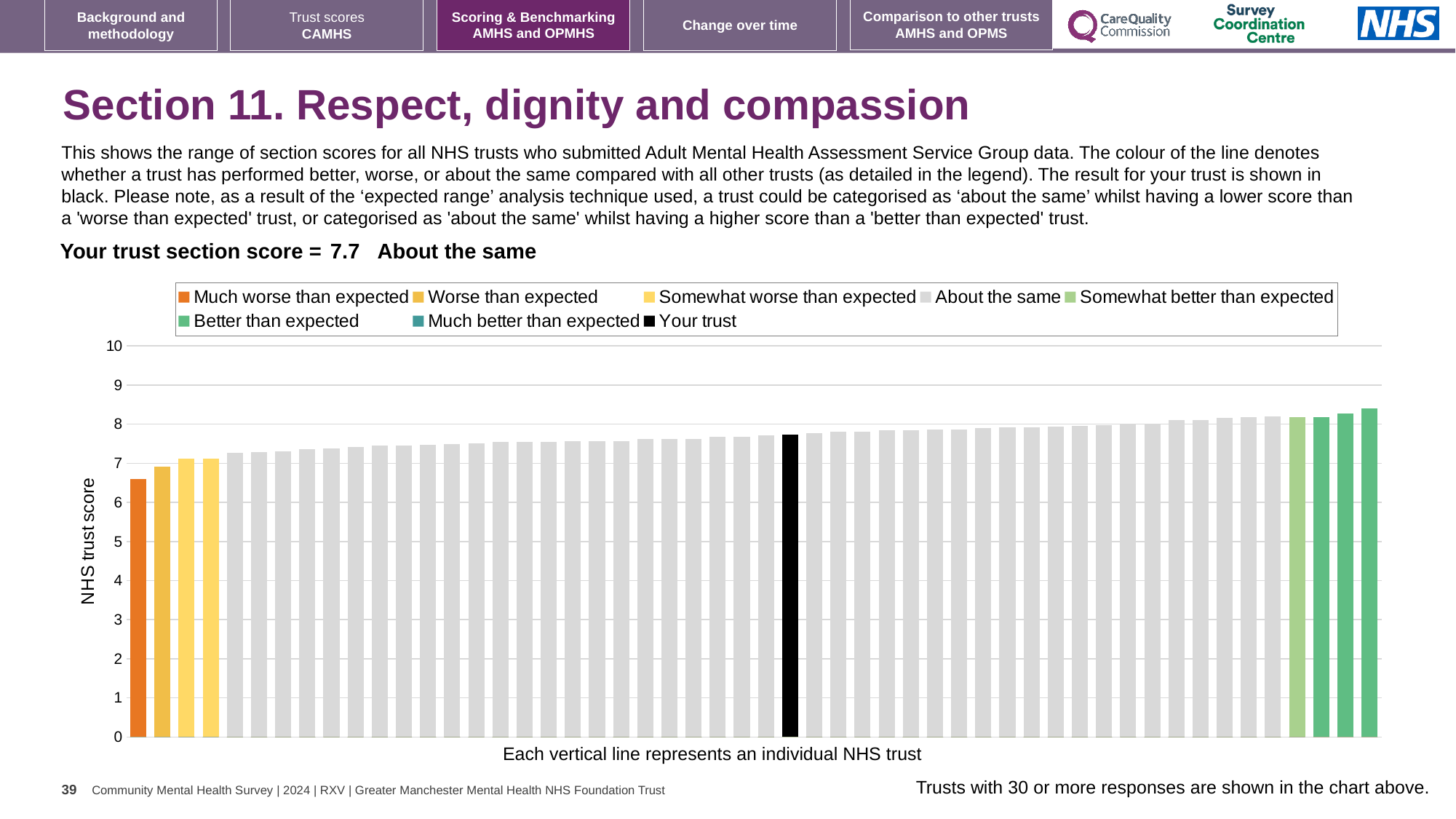
Is the value of the 'Your trust' bar greater or less than 7? greater What is the label on the vertical axis of the chart? NHS trust score Is the 'Much worse than expected' bar higher or lower than the 'Your trust' bar? lower Which legend category do the highest bars in the chart belong to? Better than expected How many bars are coloured as 'Better than expected'? 3 Do the bar values rise or fall from left to right along the x axis? rise Is the value of the highest bar greater or less than 8? greater What is the section score for 'Your trust' shown on the slide? 7.7 What kind of chart is shown on the slide? bar chart Which legend category does the lowest bar in the chart belong to? Much worse than expected Is the value of the lowest bar (the 'Much worse than expected' trust) greater or less than 7? less How many entries does the chart legend list? 8